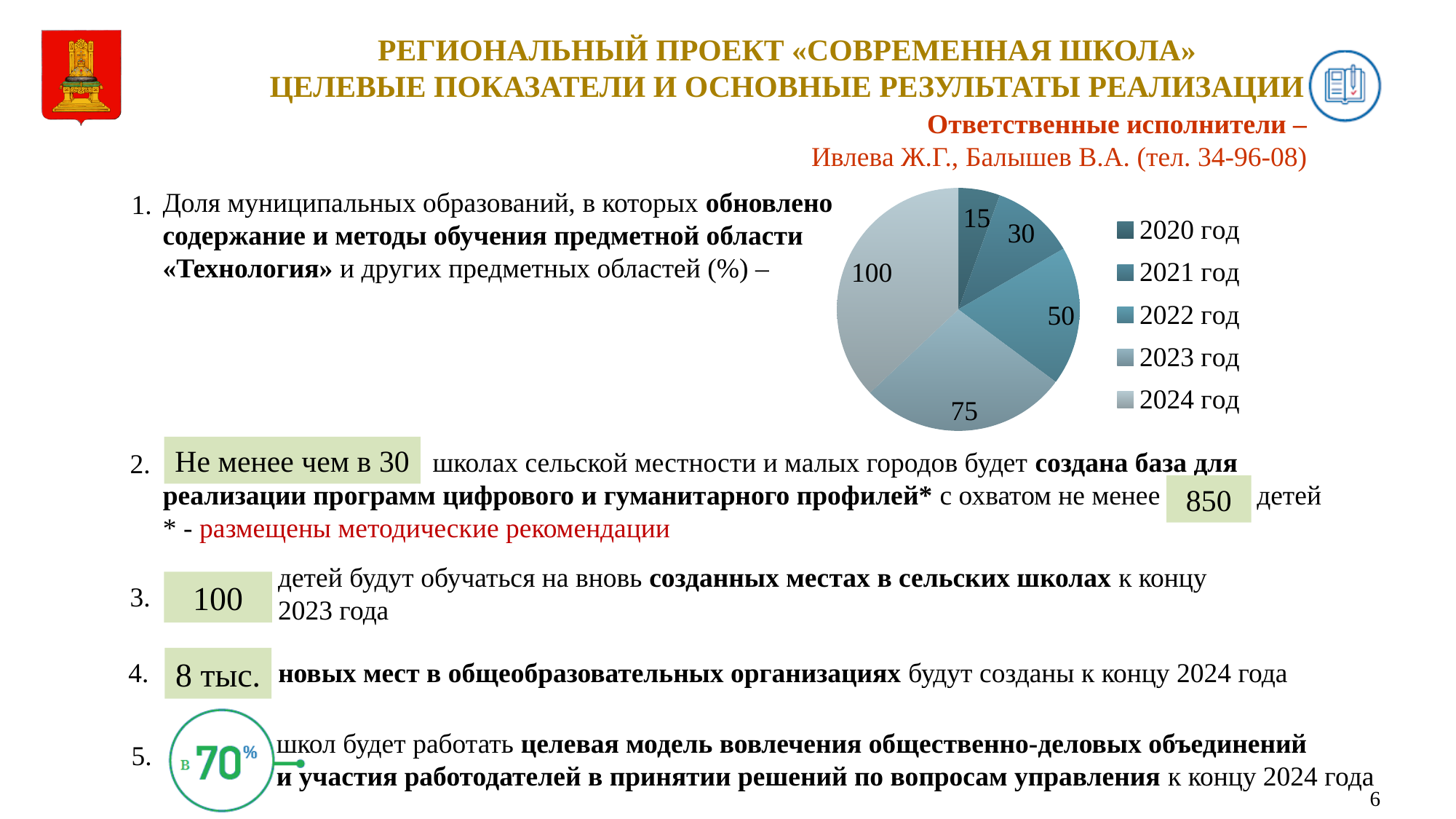
What is the value for 2021 год in the pie chart? 30 What kind of chart is shown on the slide? pie chart How many slices does the pie chart have? 5 What is the value for 2024 год in the pie chart? 100 What is the value for 2023 год in the pie chart? 75 What is the value for 2022 год in the pie chart? 50 What is the value for 2020 год in the pie chart? 15 Do the values in the pie chart rise or fall from 2020 год to 2024 год? rise What is the difference between the values for 2024 год and 2023 год in the pie chart? 25 Which is larger in the pie chart, the value for 2021 год or the value for 2022 год? 2022 год Which year has the smallest slice in the pie chart? 2020 год Which year has the largest slice in the pie chart? 2024 год